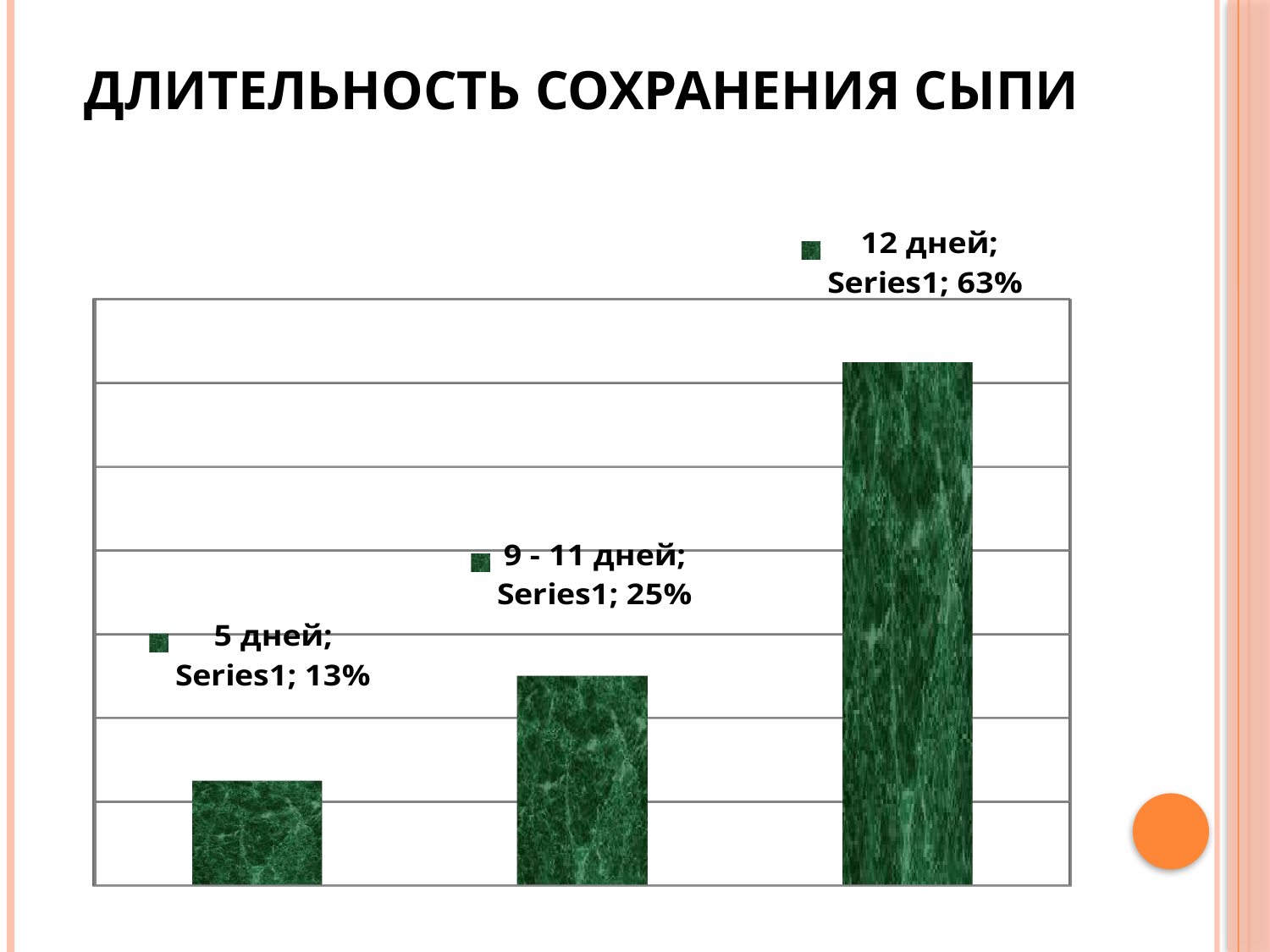
Which category has the highest value? 12 дней What kind of chart is shown on the slide? Bar chart Which category has the lowest value? 5 дней What is the value for the category "5 дней"? 13% How many categories are shown in the chart? 3 What is the value for the category "12 дней"? 63% What is the title of the slide? ДЛИТЕЛЬНОСТЬ СОХРАНЕНИЯ СЫПИ Which is larger, the value for "5 дней" or the value for "9 - 11 дней"? 9 - 11 дней What is the value for the category "9 - 11 дней"? 25% Do the values rise or fall from left to right along the x axis? Rise What is the difference between the values for "12 дней" and "9 - 11 дней"? 38% What is the difference between the values for "9 - 11 дней" and "5 дней"? 12%